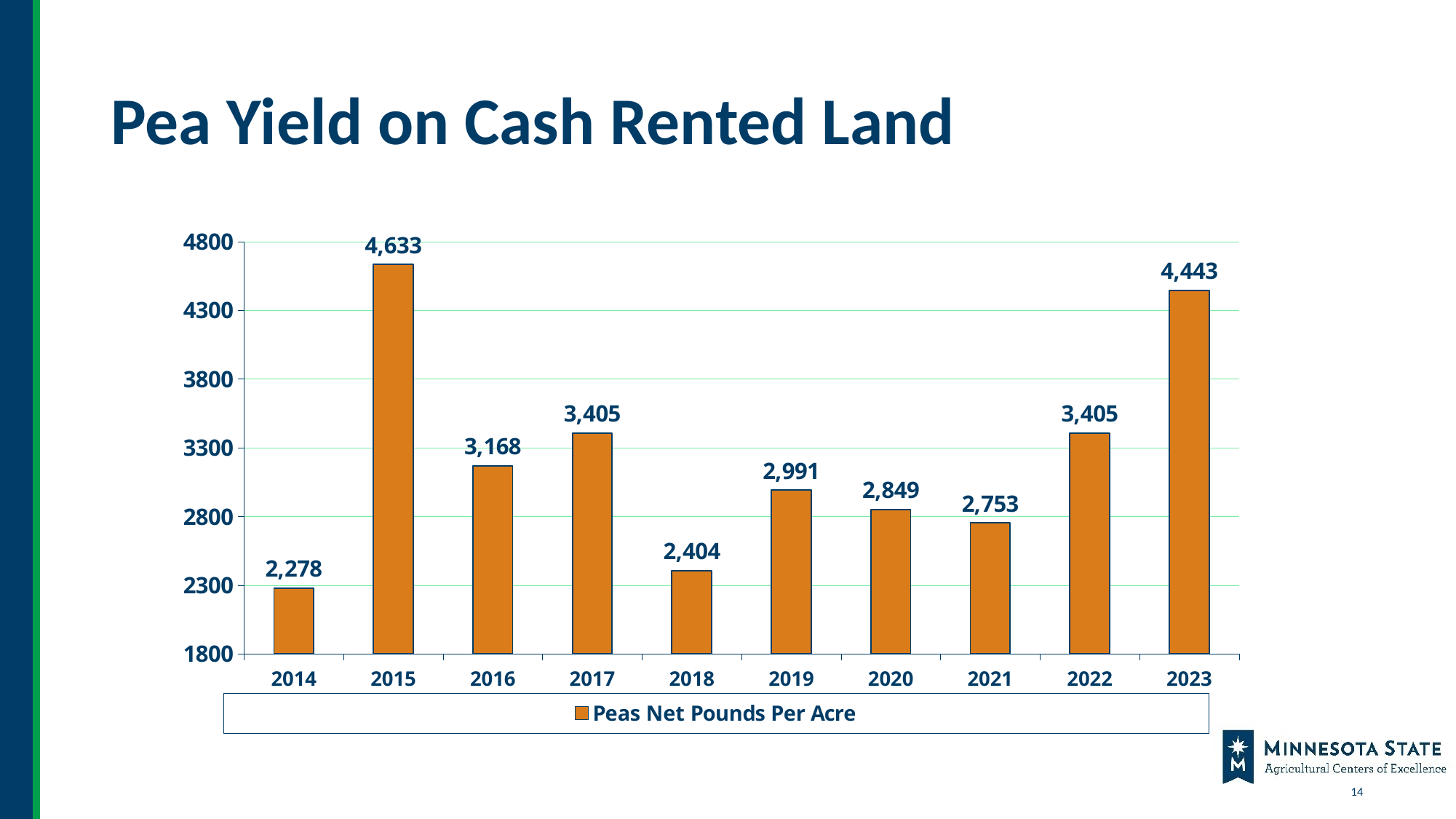
What is the legend entry for the series shown in the chart? Peas Net Pounds Per Acre Which year has the highest pea yield? 2015 What is the difference between the pea yield in 2015 and in 2023? 190 What kind of chart is shown on the slide? Bar chart Is the pea yield for 2016 greater or less than 2800? greater What is the difference between the pea yield in 2023 and in 2014? 2,165 What is the pea yield (net pounds per acre) for 2021? 2,753 How many years are shown on the chart? 10 What is the pea yield (net pounds per acre) for 2015? 4,633 What is the pea yield (net pounds per acre) for 2018? 2,404 Which year has the lowest pea yield? 2014 Which year has the larger pea yield, 2019 or 2020? 2019